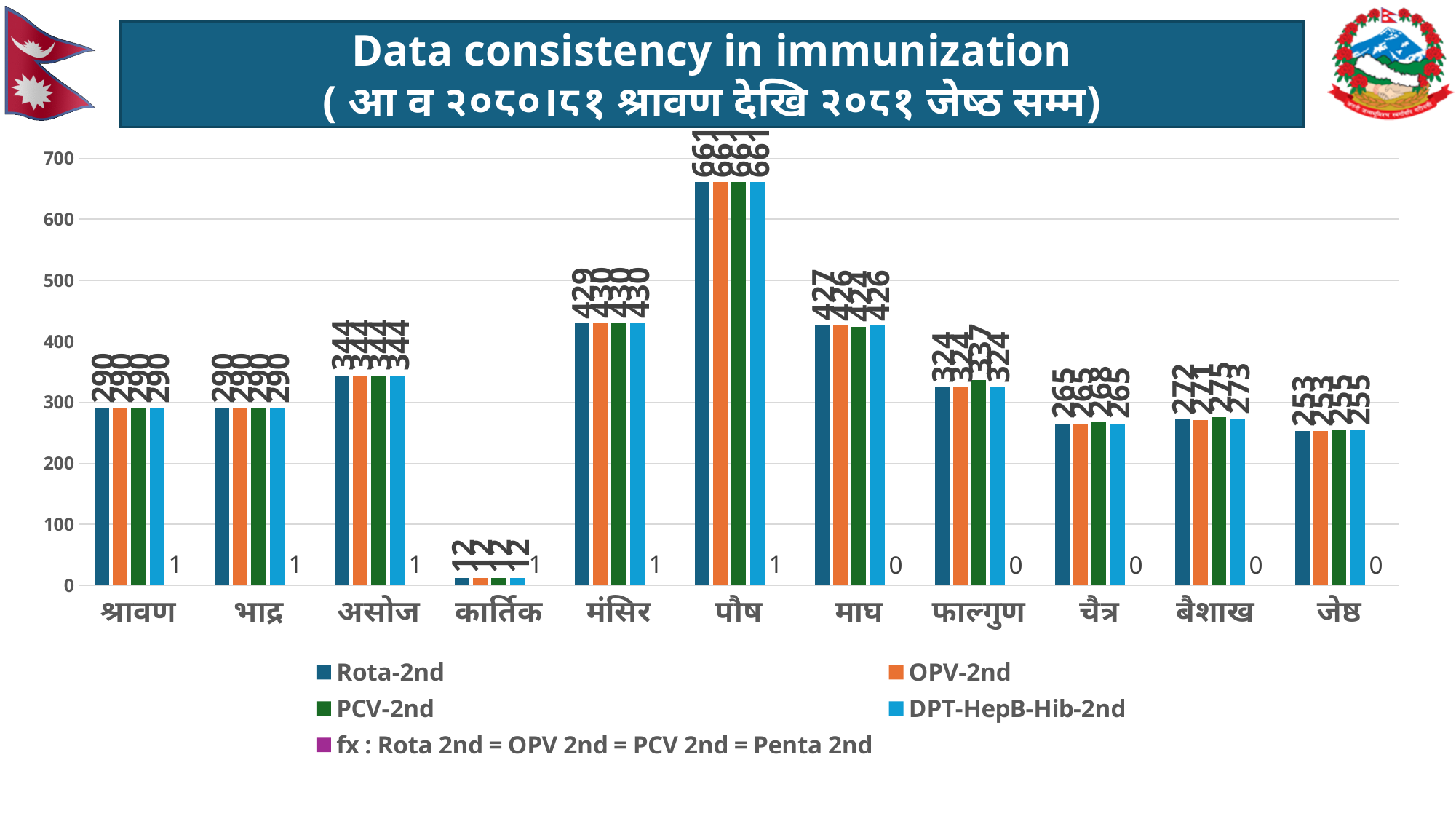
What is the Rota-2nd value for श्रावण? 290 Which month has the highest immunization values? पौष What is the DPT-HepB-Hib-2nd value for असोज? 344 Which month has the lowest immunization values? कार्तिक What is the difference between the Rota-2nd values for असोज and श्रावण? 54 What kind of chart is shown on the slide? bar chart Which month has the larger OPV-2nd value, असोज or भाद्र? असोज How many series does the legend list? 5 How many months (categories) are shown along the x axis? 11 What is the value of the fx series for माघ? 0 Is the Rota-2nd value for पौष greater or less than 600? greater What is the PCV-2nd value for फाल्गुण? 337